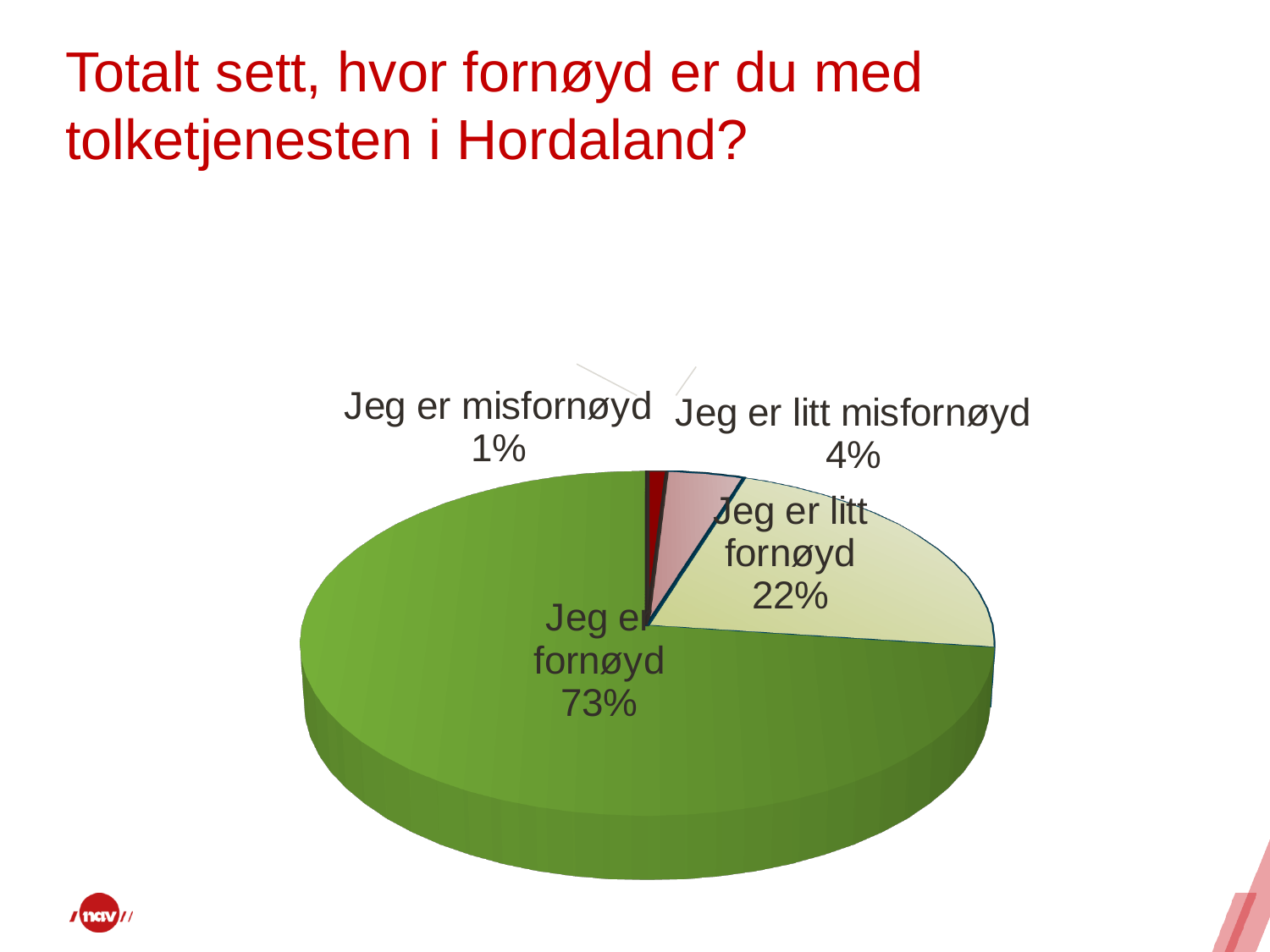
What kind of chart is shown on the slide? pie chart What share of respondents answered "Jeg er litt fornøyd"? 22% Which response has the largest slice of the pie? Jeg er fornøyd Which response has the smallest slice of the pie? Jeg er misfornøyd Which is larger, the share for "Jeg er litt misfornøyd" or the share for "Jeg er misfornøyd"? Jeg er litt misfornøyd What is the title of the slide containing the pie chart? Totalt sett, hvor fornøyd er du med tolketjenesten i Hordaland? What is the difference in percentage points between "Jeg er fornøyd" and "Jeg er litt fornøyd"? 51 percentage points What share of respondents answered "Jeg er fornøyd"? 73% What share of respondents answered "Jeg er misfornøyd"? 1% What share of respondents answered "Jeg er litt misfornøyd"? 4% How many slices does the pie chart have? 4 What is the combined share of "Jeg er litt misfornøyd" and "Jeg er misfornøyd"? 5%